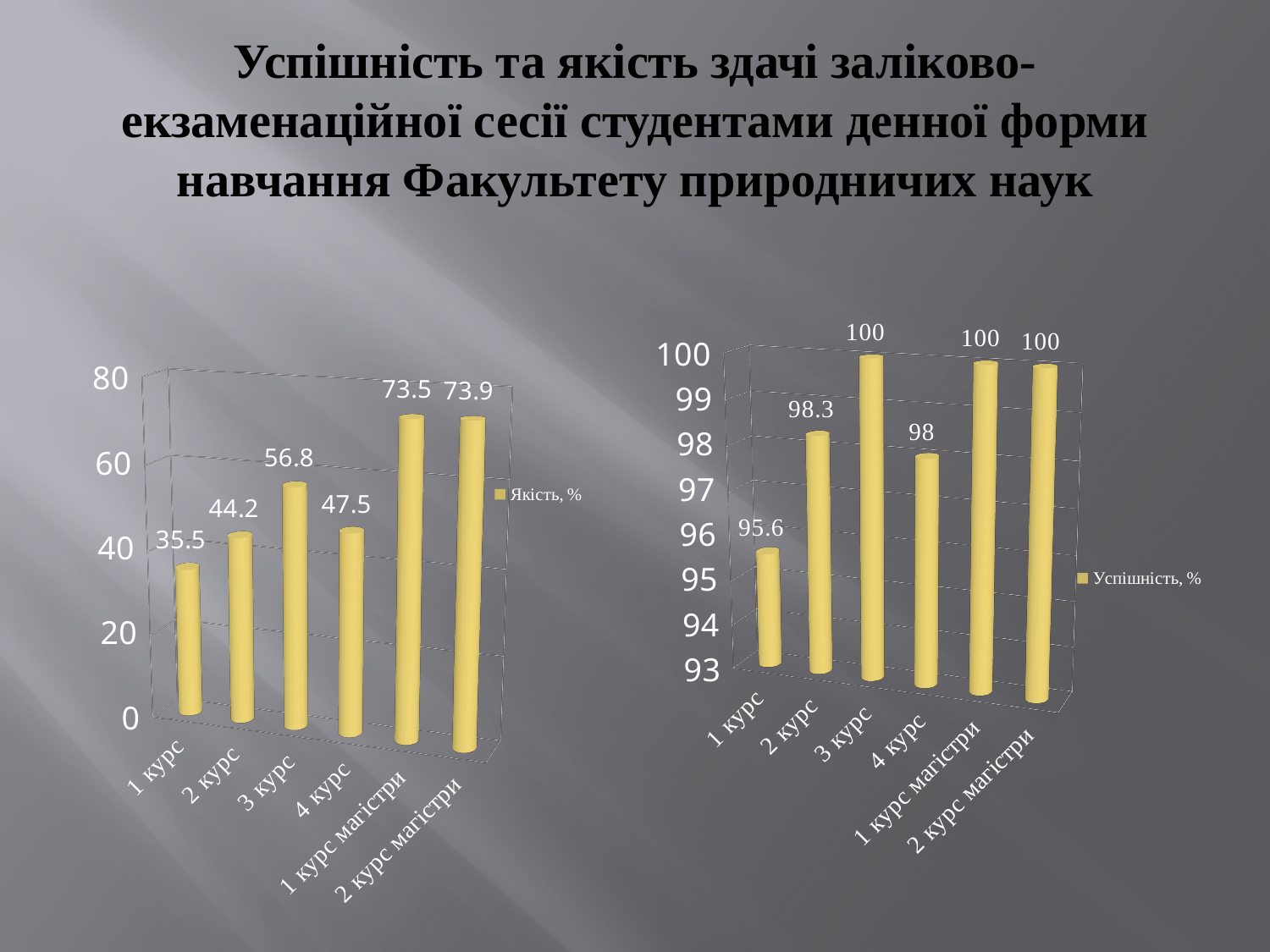
In the left chart (Якість, %), what is the difference between the values for 3 курс and 4 курс? 9.3 In the right chart (Успішність, %), which category has the lowest value? 1 курс In the left chart (Якість, %), what is the value for 3 курс? 56.8 What is the legend entry of the left chart? Якість, % In the left chart (Якість, %), which is larger: the value for 2 курс or the value for 4 курс? 4 курс What kind of chart is the right chart (Успішність, %)? bar chart In the right chart (Успішність, %), what is the difference between the values for 2 курс and 1 курс? 2.7 In the right chart (Успішність, %), what is the value for 2 курс? 98.3 In the left chart (Якість, %), which category has the lowest value? 1 курс In the left chart (Якість, %), which category has the highest value? 2 курс магістри In the right chart (Успішність, %), is the value for 4 курс greater or less than 97? greater How many categories are shown in the left chart (Якість, %)? 6